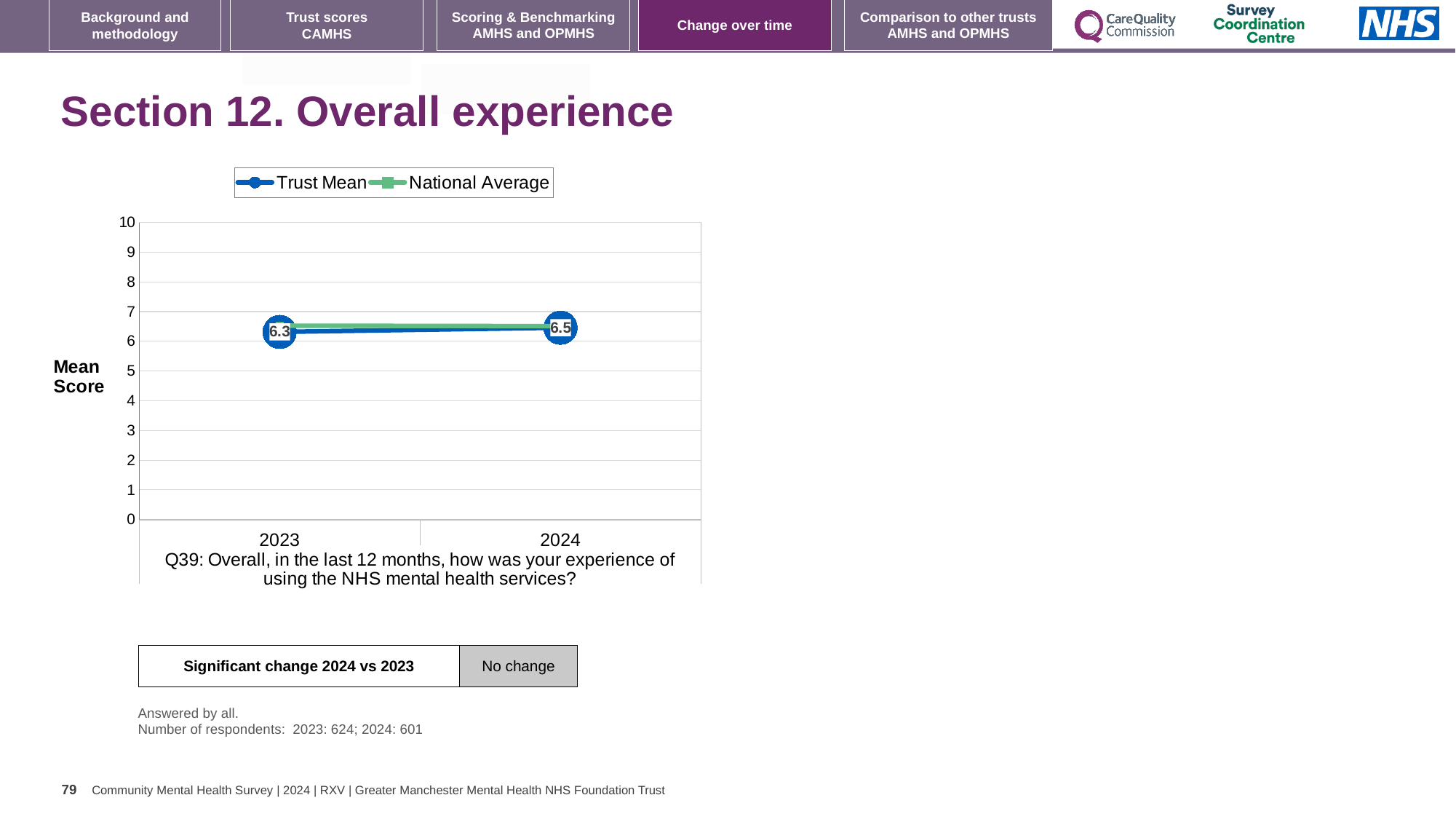
In 2023, which is higher: the Trust Mean or the National Average? National Average What is the Trust Mean score for 2024? 6.5 What is the label on the y axis of the chart? Mean Score By how much did the Trust Mean change from 2023 to 2024? 0.2 What kind of chart is shown on the slide? line chart Is the National Average value for 2023 greater or less than 5? greater How many series does the chart legend list? 2 How many years are shown on the x axis of the chart? 2 What is the Trust Mean score for 2023? 6.3 In which year is the Trust Mean at its highest? 2024 Which year has the higher Trust Mean score, 2023 or 2024? 2024 Does the Trust Mean rise or fall from 2023 to 2024? rise